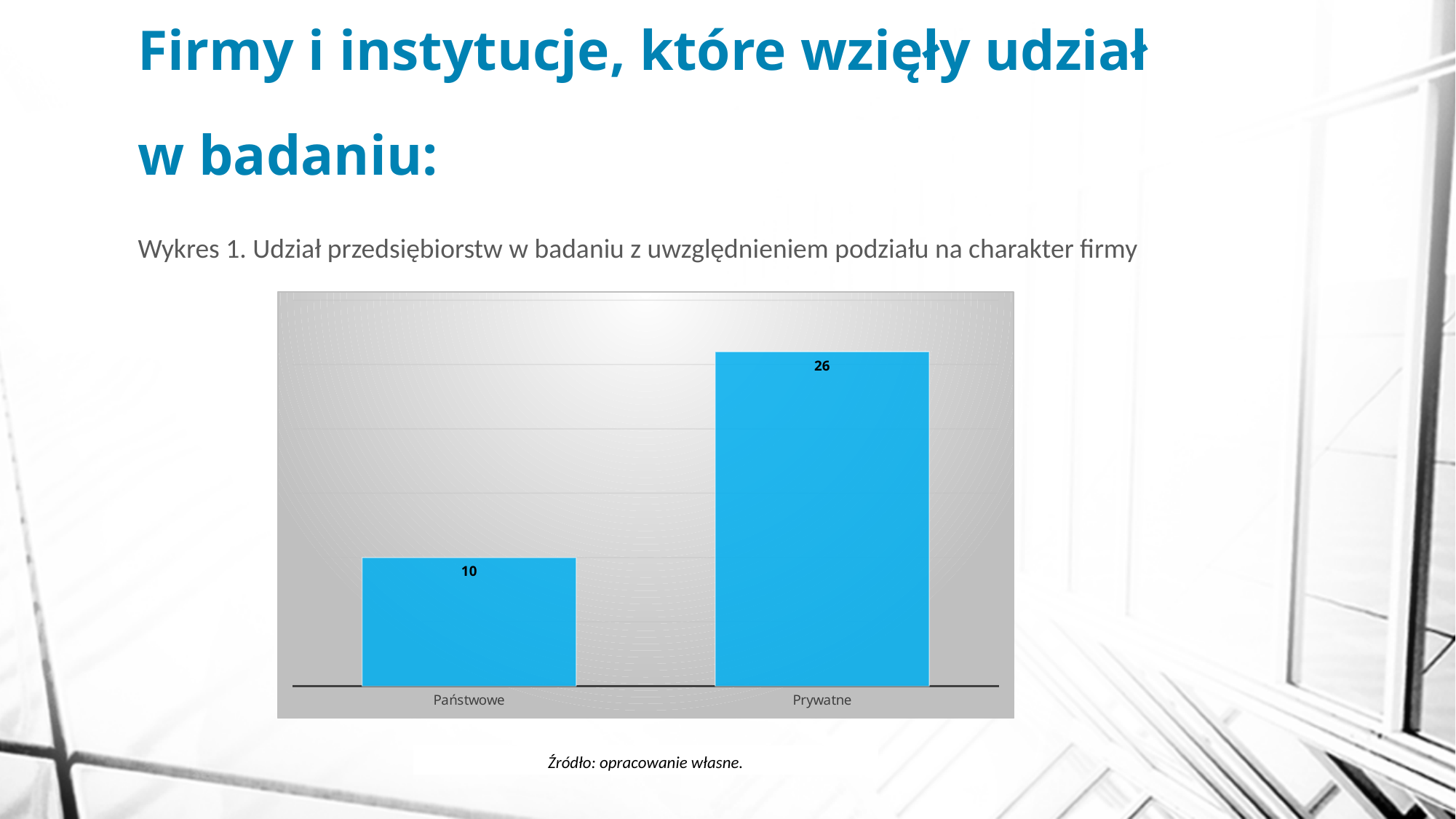
Which category has the lowest value? Państwowe What is the total of the two values shown on the chart? 36 Which is larger, the value for Państwowe or the value for Prywatne? Prywatne What is the value for Państwowe? 10 What is the difference between the values for Prywatne and Państwowe? 16 Which category has the highest value? Prywatne What kind of chart is shown on the slide? Bar chart What colour are the bars on the chart? Blue How many categories are shown on the chart? 2 What is the caption of the chart (Wykres 1)? Udział przedsiębiorstw w badaniu z uwzględnieniem podziału na charakter firmy What is the value for Prywatne? 26